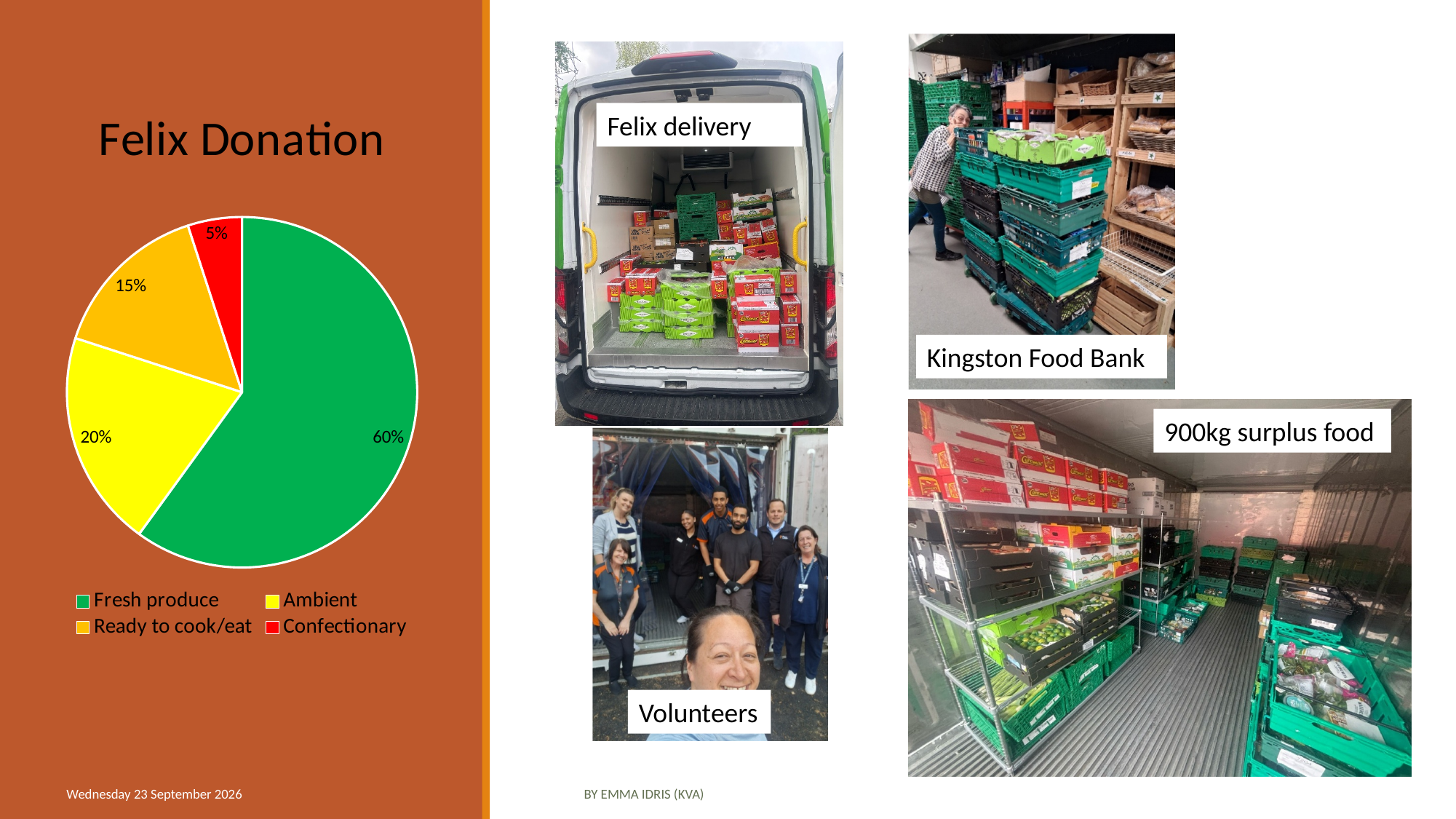
Which is larger, Ambient or Ready to cook/eat? Ambient How many categories does the pie chart have? 4 What is the value for Ready to cook/eat? 15% What is the value for Ambient? 20% What colour is the Confectionary slice? red Which category has the smallest share of the pie? Confectionary What is the value for Confectionary? 5% What type of chart is shown on the slide? pie chart What is the difference between the Fresh produce and Ambient shares? 40% What share of the pie does Fresh produce represent? 60% Which category has the largest share of the pie? Fresh produce What is the title of the chart? Felix Donation